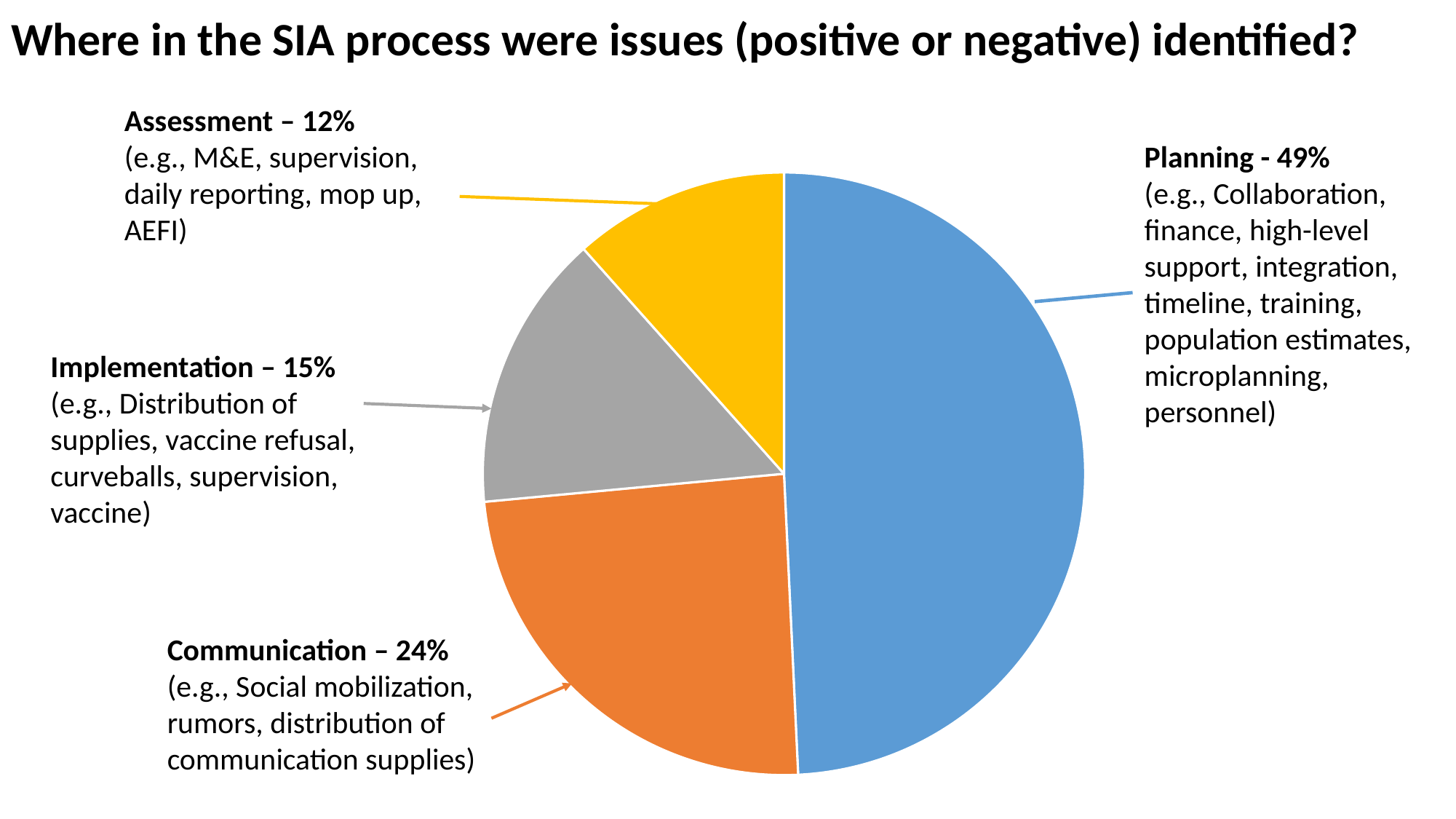
What kind of chart is shown on the slide? Pie chart Which stage of the SIA process has the smallest share of identified issues? Assessment What is the difference in percentage points between the Implementation and Assessment shares? 3 What share of issues were identified in the Implementation stage? 15% Which stage of the SIA process has the largest share of identified issues? Planning Which has a larger share, Communication or Implementation? Communication What is the difference in percentage points between the Planning and Communication shares? 25 How many stages (slices) are shown in the pie chart? 4 What share of issues were identified in the Planning stage? 49% What share of issues were identified in the Communication stage? 24% What share of issues were identified in the Assessment stage? 12% What colour is the slice representing Planning? Blue